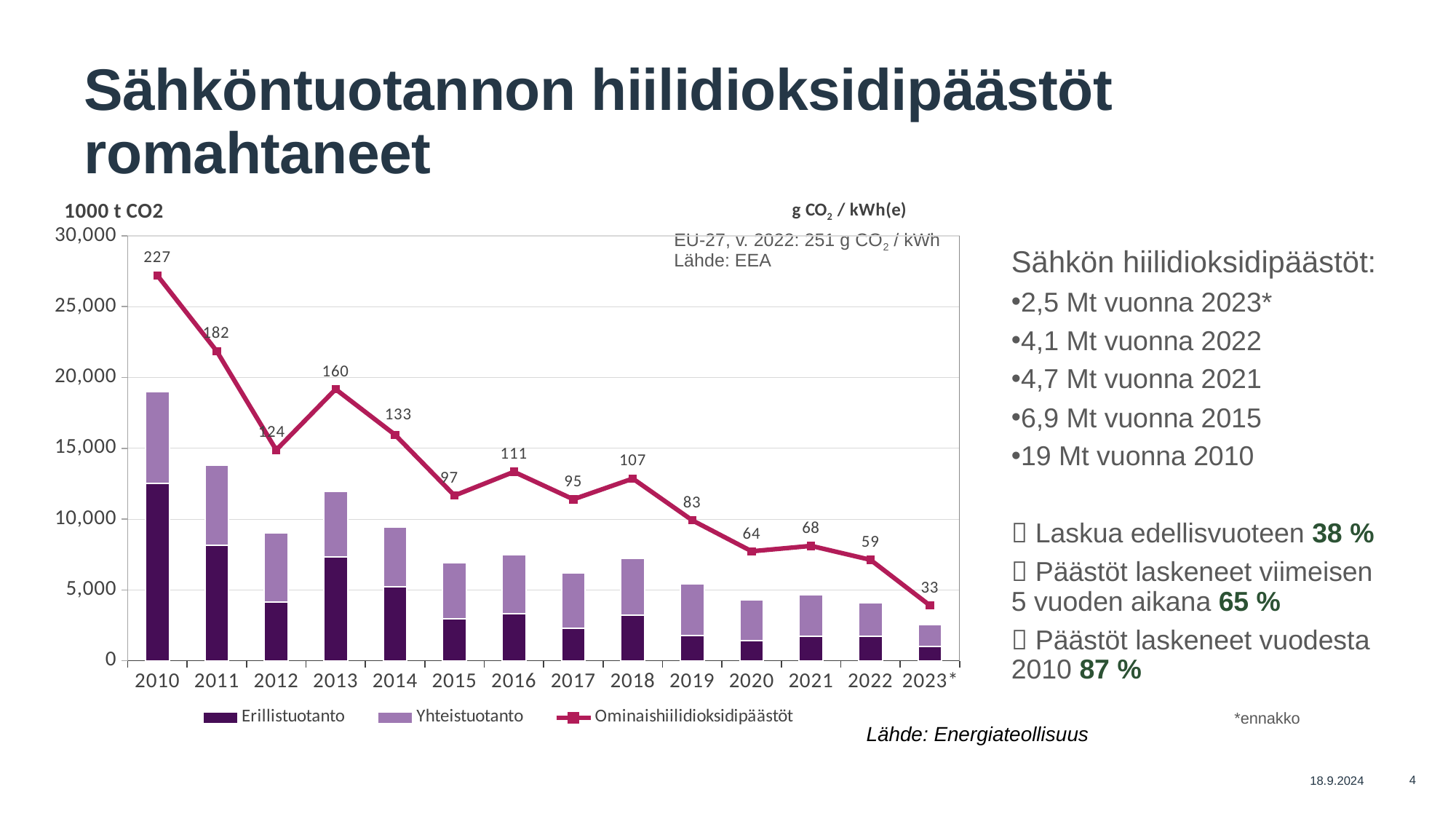
How many series does the chart legend list? 3 What is the value of the Ominaishiilidioksidipäästöt line for 2010? 227 Is the total stacked bar for 2023 greater or less than 5,000? less What is the overall trend of the Ominaishiilidioksidipäästöt line from 2010 to 2023? falling What is the value of the Ominaishiilidioksidipäästöt line for 2023? 33 How many years are shown on the x axis of the chart? 14 In which year is the Ominaishiilidioksidipäästöt line at its highest? 2010 Is the total stacked bar for 2010 greater or less than 15,000? greater Which year has the larger Ominaishiilidioksidipäästöt value, 2013 or 2014? 2013 In which year is the Ominaishiilidioksidipäästöt line at its lowest? 2023 What is the difference between the Ominaishiilidioksidipäästöt values for 2010 and 2011? 45 What is the value of the Ominaishiilidioksidipäästöt line for 2016? 111